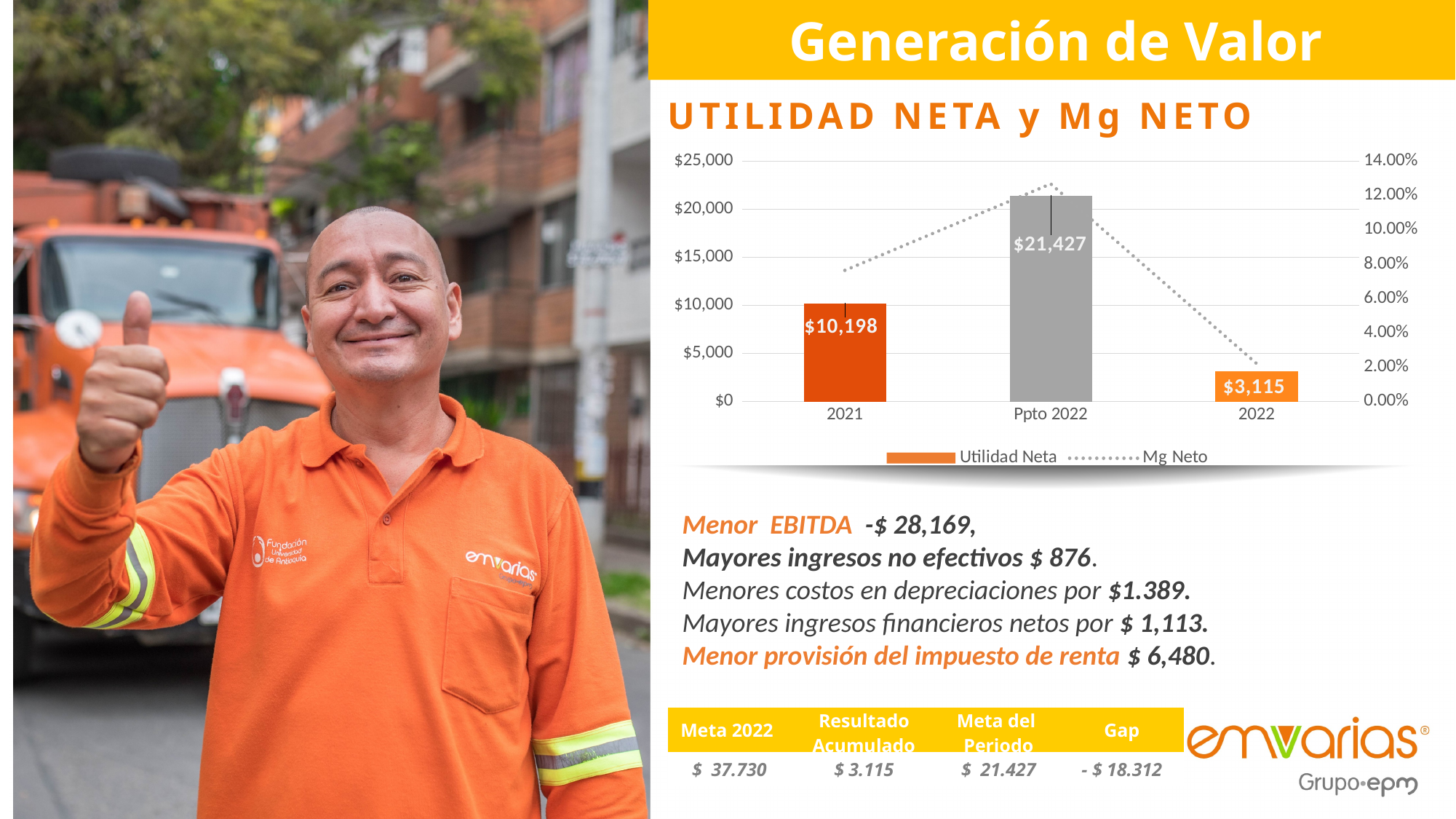
What is the Utilidad Neta value for 2021? $10,198 Which category has the highest Utilidad Neta? Ppto 2022 Is the Mg Neto value for Ppto 2022 greater or less than 10.00%? greater How many series does the chart legend list? 2 What is the difference between the Utilidad Neta for Ppto 2022 and for 2022? $18,312 How many categories are shown on the x axis of the chart? 3 Which is larger, the Utilidad Neta for 2021 or for 2022? 2021 What is the title of the chart? UTILIDAD NETA y Mg NETO What is the Utilidad Neta value for Ppto 2022? $21,427 Is the Mg Neto value for 2022 greater or less than 4.00%? less What is the Utilidad Neta value for 2022? $3,115 Which category has the lowest Utilidad Neta? 2022